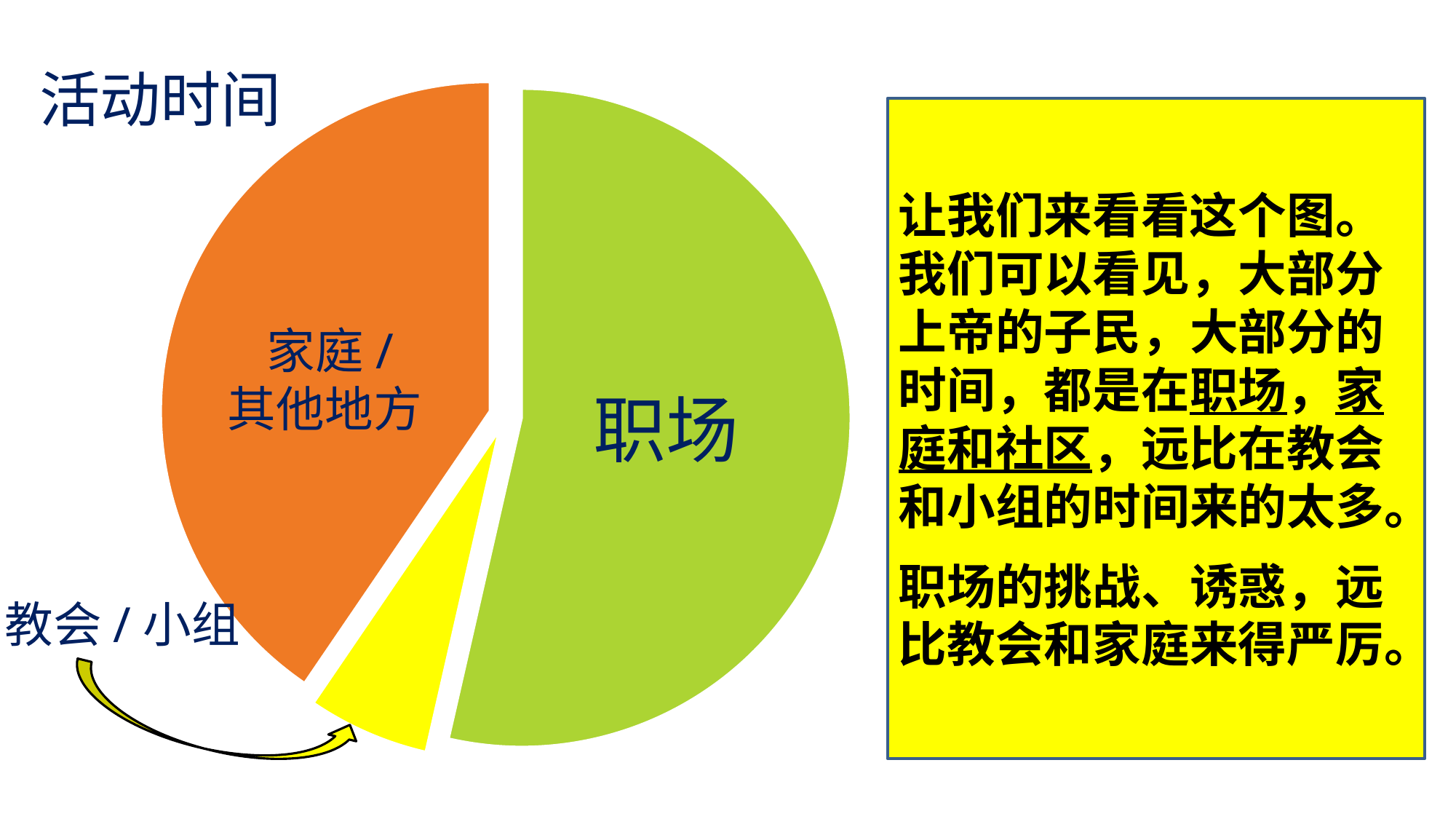
Which category has the smallest slice of the pie? 教会 / 小组 Which slice is larger, 家庭 / 其他地方 or 教会 / 小组? 家庭 / 其他地方 What is the title of the chart? 活动时间 How many slices does the pie chart have? 3 Which category has the largest slice of the pie? 职场 What kind of chart is shown on the slide? pie chart Which slice is larger, 职场 or 家庭 / 其他地方? 职场 What colour is the 职场 slice? green Which slice is smaller, 职场 or 教会 / 小组? 教会 / 小组